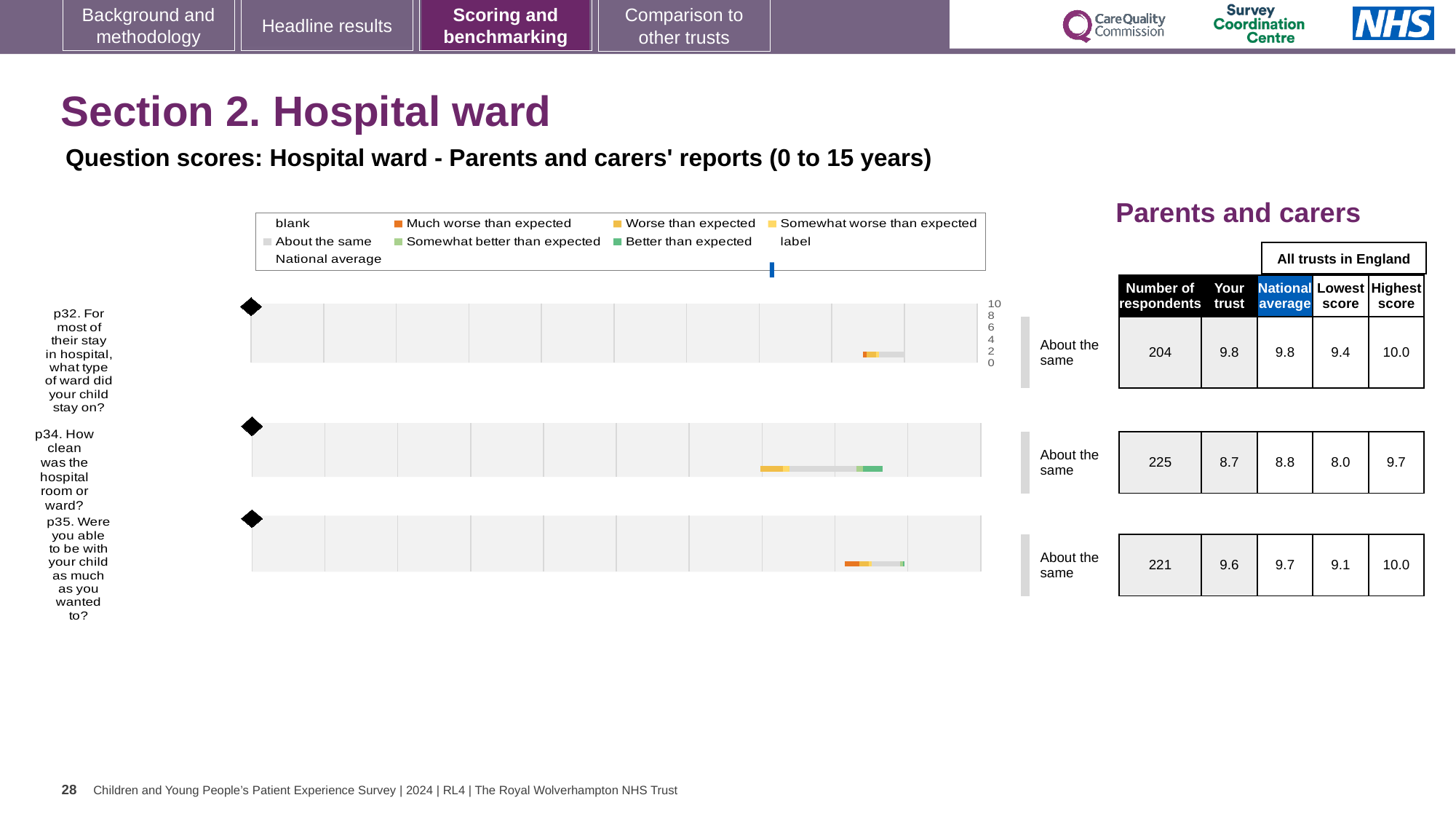
What kind of chart is used to show the question scores on this slide? bar chart Which question has the lowest 'Your trust' score: p32, p34 or p35? p34 For p35, what is the difference between the highest score and the lowest score among all trusts in England? 0.9 In the chart legend, what colour represents 'Better than expected'? green What is the 'Your trust' score for p34 (How clean was the hospital room or ward?)? 8.7 Which question has the highest 'Your trust' score: p32, p34 or p35? p32 What is the lowest score among all trusts in England for p32? 9.4 How many respondents answered p35 (Were you able to be with your child as much as you wanted to)? 221 What is the highest score among all trusts in England for p34? 9.7 What is the national average score for p32 (what type of ward did your child stay on)? 9.8 What benchmark category is shown next to each of the three question bars? About the same How many questions (p32, p34, p35) are plotted as separate bars on the slide? 3